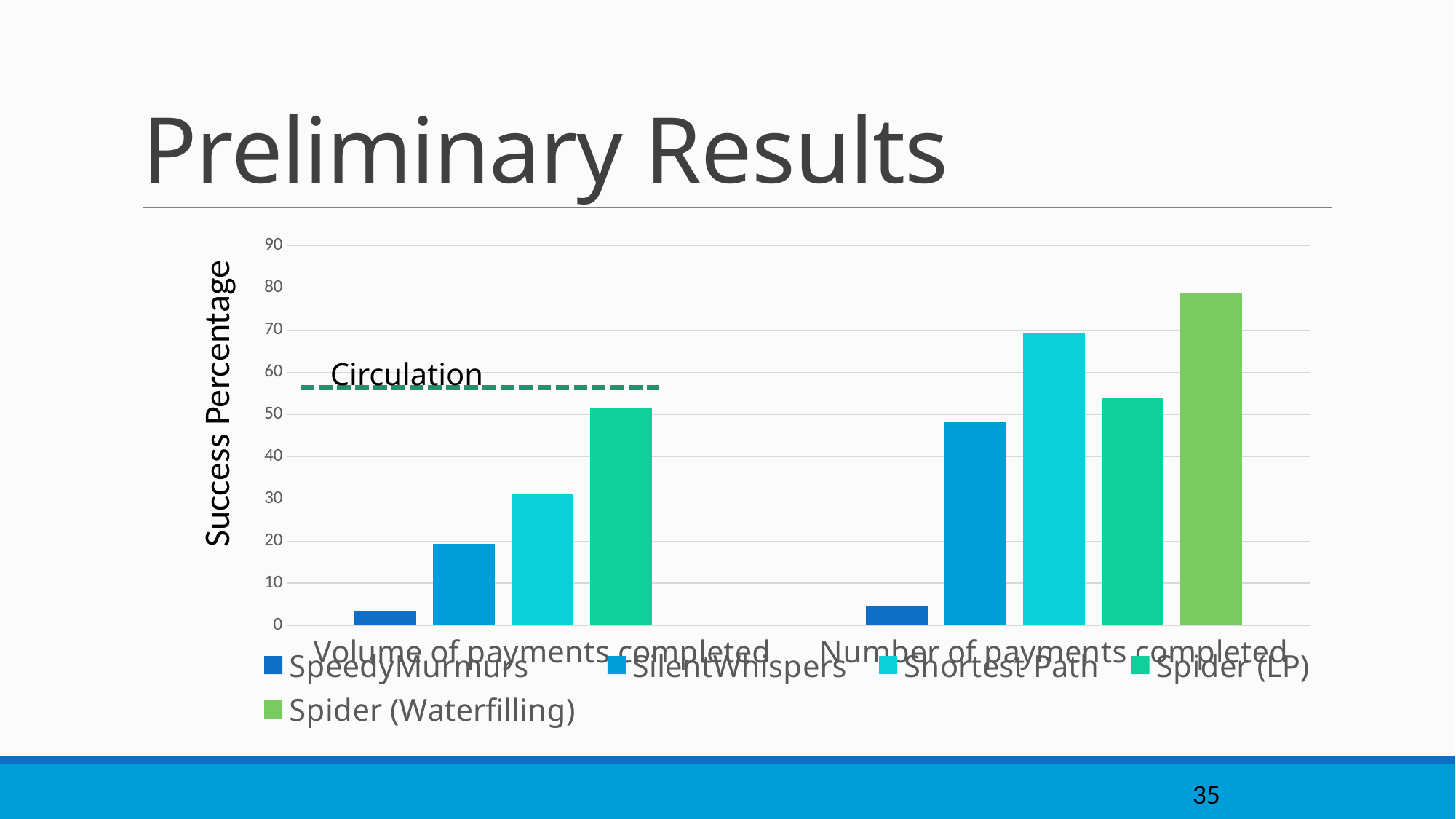
Is the value for Shortest Path in 'Number of payments completed' greater or less than 60? greater Is the value for SpeedyMurmurs in 'Number of payments completed' greater or less than 10? less How many categories are shown on the x axis? 2 What label is attached to the dashed horizontal line in the chart? Circulation What is the label of the vertical axis? Success Percentage How many series does the legend list? 5 Which series has the lowest bar in the 'Volume of payments completed' category? SpeedyMurmurs What kind of chart is shown on the slide? bar chart Which series has the highest bar in the 'Number of payments completed' category? Spider (Waterfilling) Is the value for Spider (Waterfilling) in 'Number of payments completed' greater or less than 70? greater In the 'Number of payments completed' category, which is larger: Shortest Path or Spider (LP)? Shortest Path